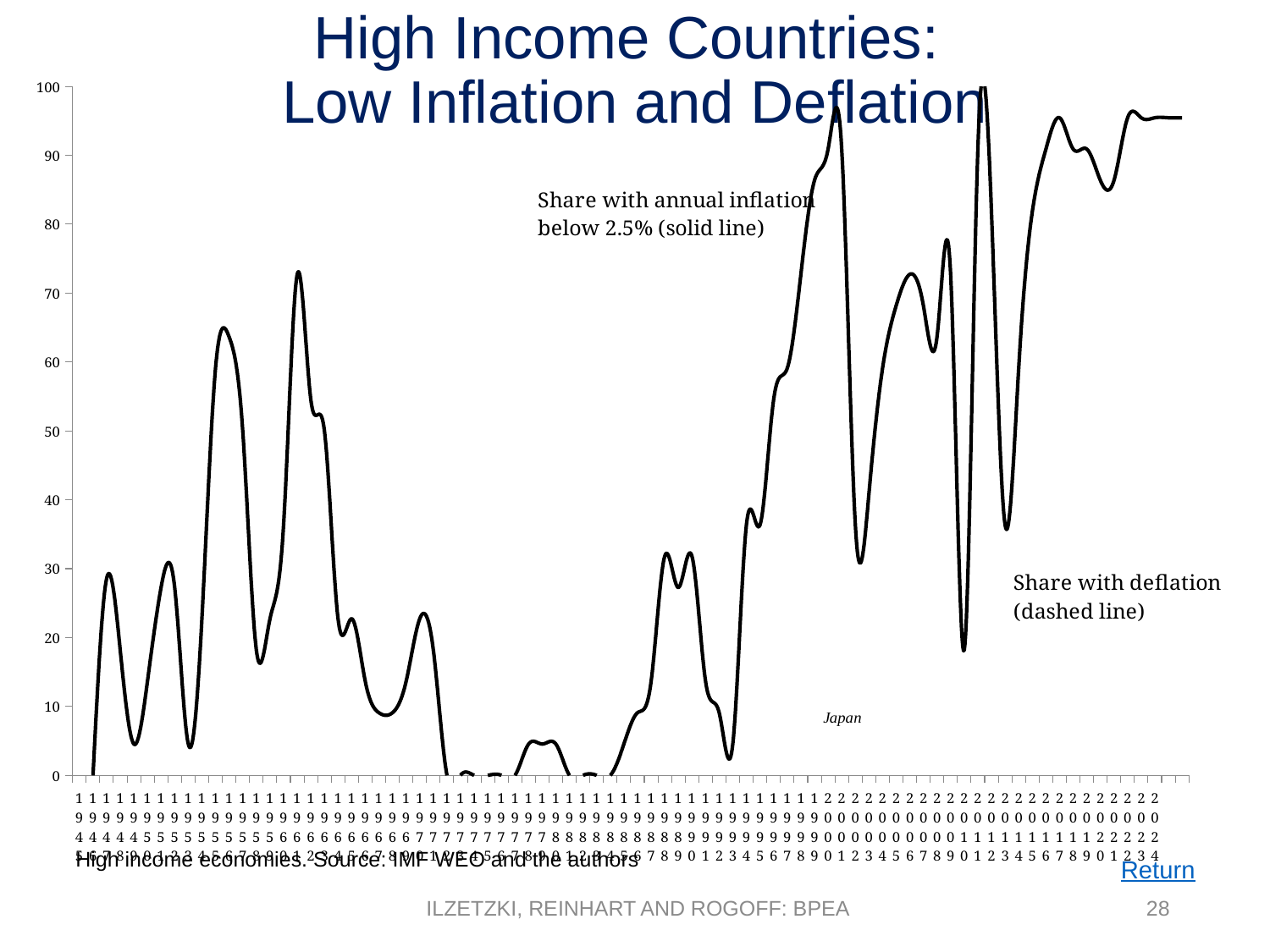
Is the value of the solid line at the first point (1945) greater or less than 10? less Overall, does the solid line rise or fall from 1945 to 2024? rise What does the solid line in the chart represent? Share with annual inflation below 2.5% Is the value of the solid line at the last point (2024) greater or less than 90? greater Which country is named in the annotation inside the chart area? Japan What is the highest value shown on the y axis of the chart? 100 What kind of chart is shown on the slide? line chart Is the value of the solid line in 1975 greater or less than 10? less How many series does the chart describe (solid and dashed lines)? 2